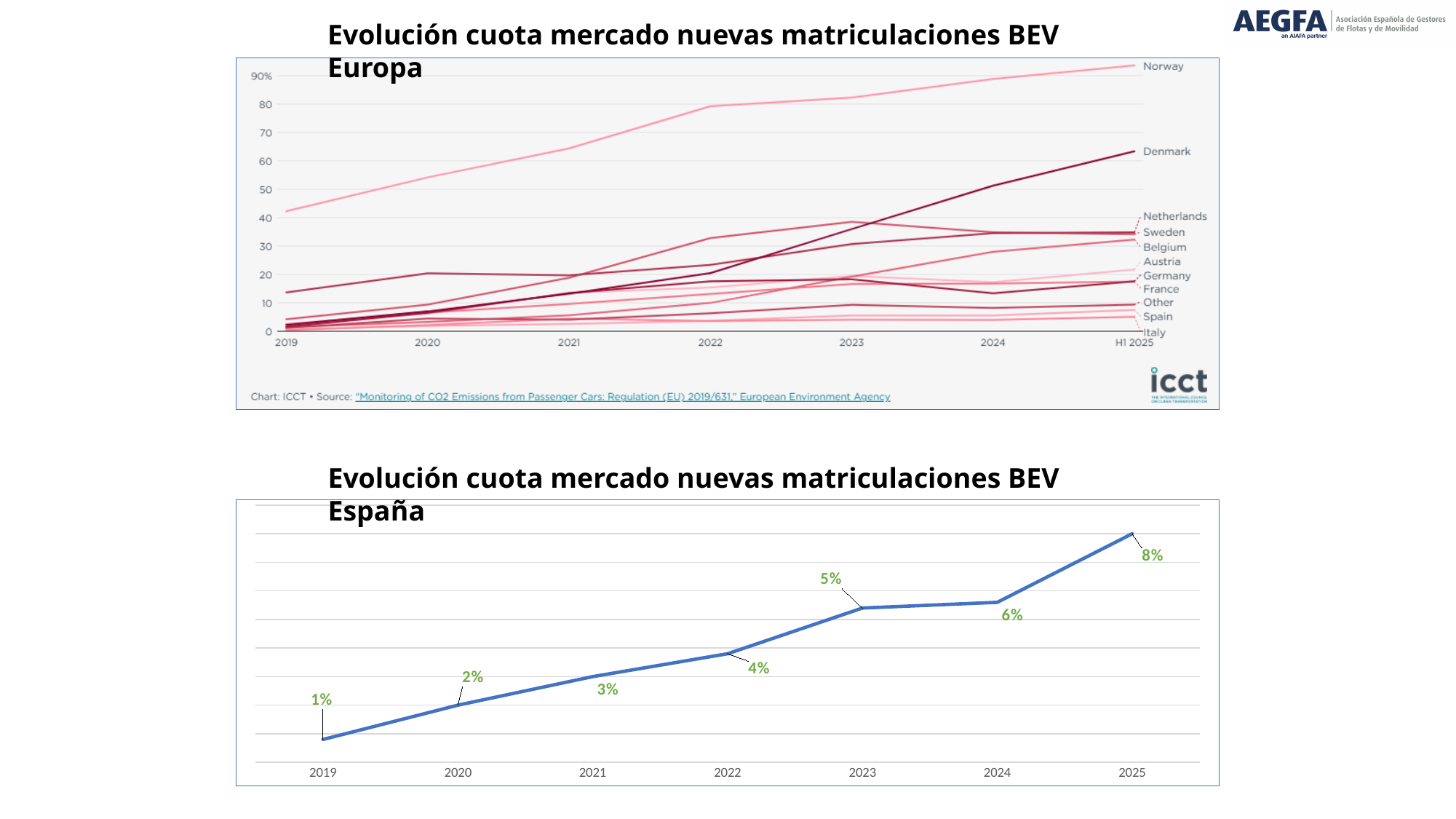
In the bottom chart (España), do the values rise or fall from 2019 to 2025? rise What kind of chart is the bottom chart, 'Evolución cuota mercado nuevas matriculaciones BEV España'? line chart In the bottom chart (España), what is the BEV market share for 2025? 8% In the bottom chart (España), which year has the lowest BEV market share? 2019 In the top chart (Europa), which country has the lowest BEV market share in H1 2025? Italy In the bottom chart (España), how many years are plotted? 7 In the top chart (Europa), is the value for Denmark in 2022 greater or less than 30%? less In the bottom chart (España), what is the BEV market share for 2022? 4% In the top chart (Europa), is the value for Norway in 2022 greater or less than 70%? greater In the top chart (Europa), which country has the highest BEV market share in H1 2025? Norway In the top chart (Europa), which is larger in H1 2025, Denmark or Sweden? Denmark In the bottom chart (España), what is the difference between the 2025 and 2024 values? 2%